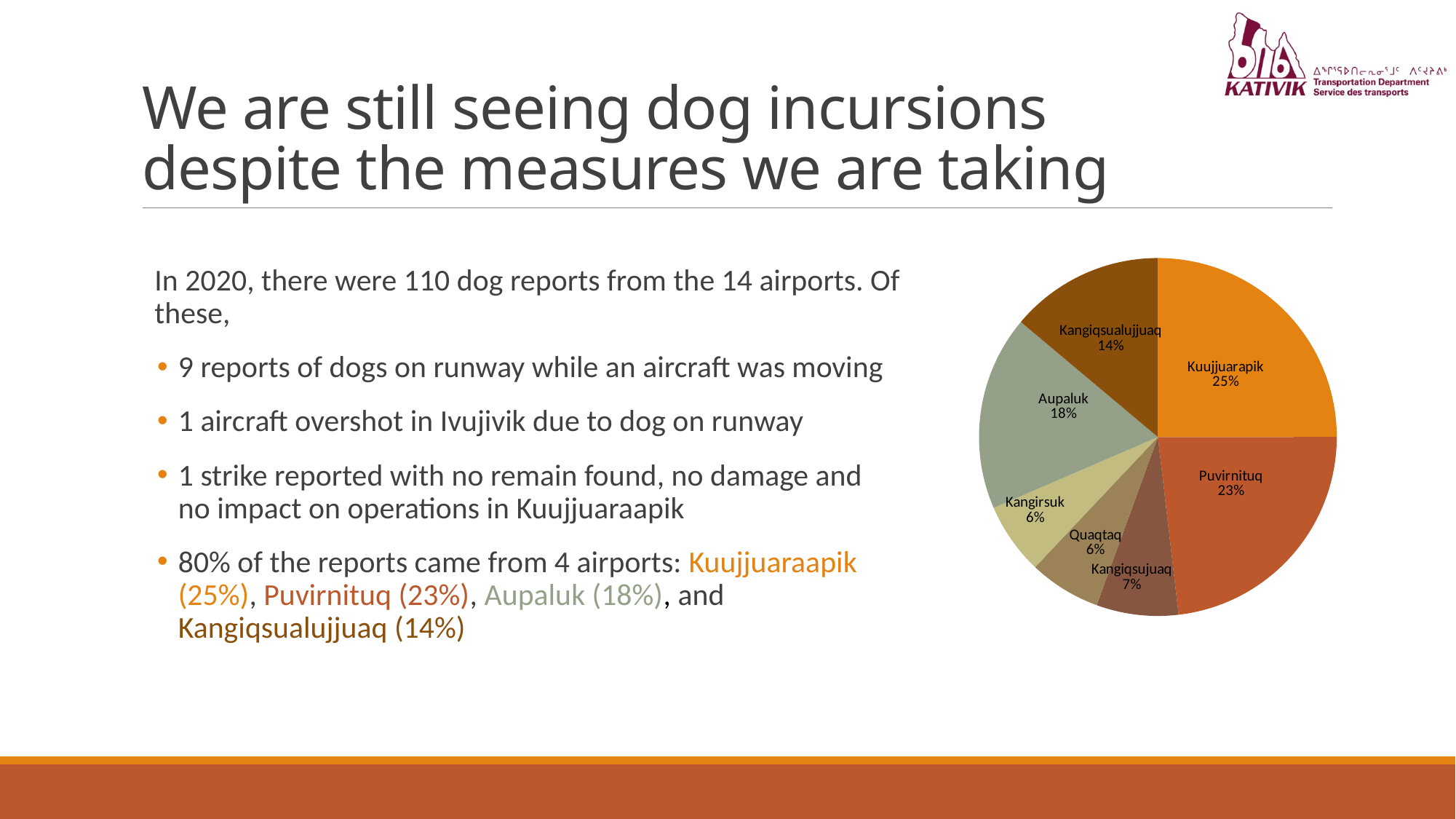
What percentage is shown for Aupaluk? 18% What is the difference in percentage points between Kuujjuarapik and Kangiqsualujjuaq? 11 What kind of chart is shown on the slide? pie chart Which airport has the largest slice of the pie? Kuujjuarapik What percentage is shown for Puvirnituq? 23% Which is larger, the slice for Aupaluk or the slice for Kangiqsujuaq? Aupaluk What percentage is shown for Kangiqsualujjuaq? 14% How many slices does the pie chart have? 7 What is the combined percentage of Kuujjuarapik and Puvirnituq? 48% What percentage is shown for Kangiqsujuaq? 7% What percentage is shown for Quaqtaq? 6% What share of the pie does Kuujjuarapik have? 25%